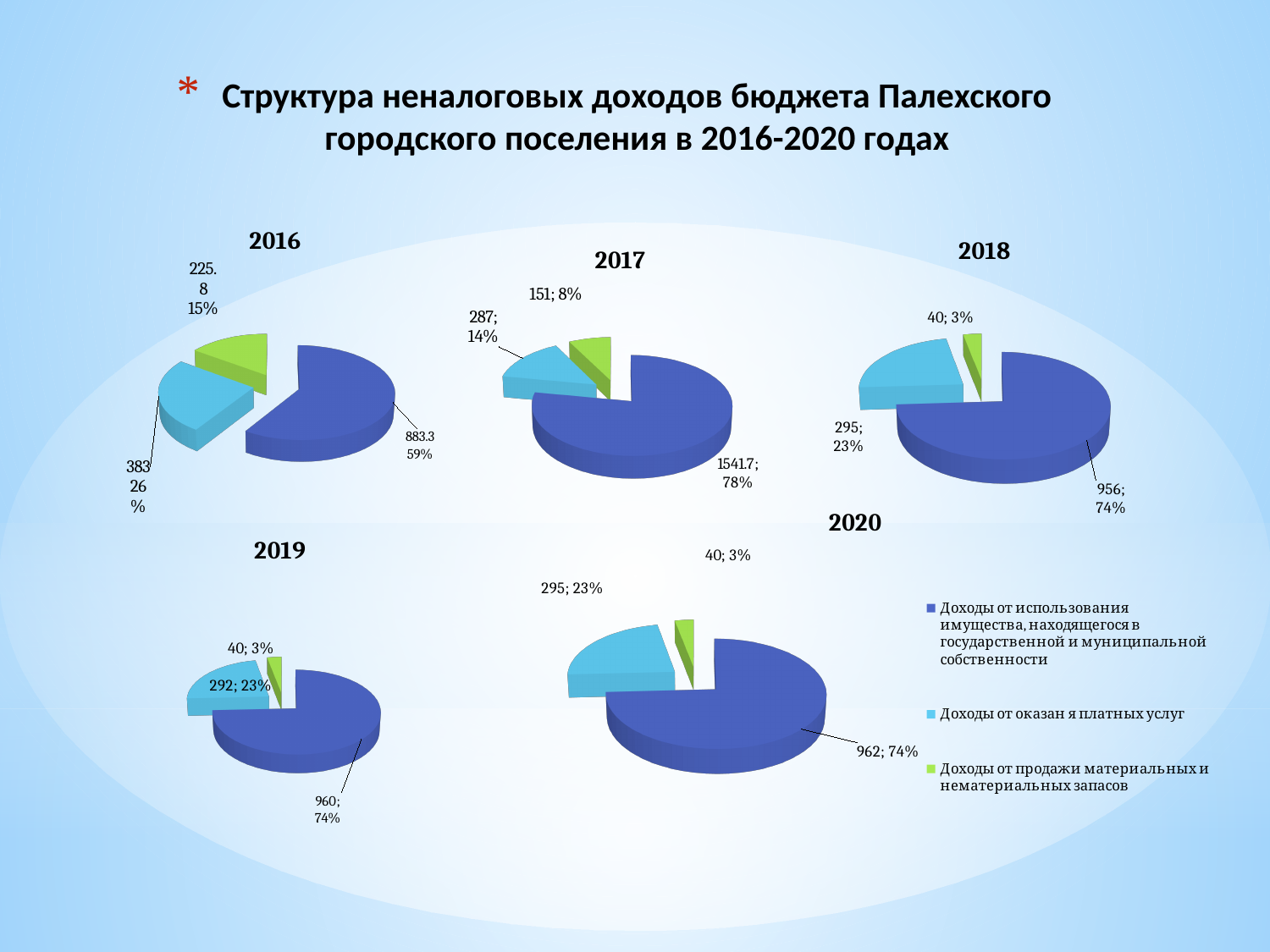
How many pie charts are shown on the slide? 5 In the 2017 pie chart, what share does the green slice (Доходы от продажи материальных и нематериальных запасов) have? 8% In the 2016 pie chart, what share does the largest slice (Доходы от использования имущества) have? 59% In the 2020 pie chart, what is the difference between the largest slice value (962) and the light blue slice value (295)? 667 In the 2019 pie chart, what value is shown for the light blue slice (Доходы от оказания платных услуг)? 292 How many series does the legend list? 3 In the 2017 pie chart, what value is shown for the largest slice? 1541.7 In the 2016 pie chart, what value is shown for the light blue slice (Доходы от оказания платных услуг)? 383 What is the title of the slide? Структура неналоговых доходов бюджета Палехского городского поселения в 2016-2020 годах In the 2018 pie chart, which category has the smallest slice? Доходы от продажи материальных и нематериальных запасов What type of chart is used for each year on the slide? Pie chart Which is larger: the largest slice value in 2017 (1541.7) or the largest slice value in 2018 (956)? 2017 (1541.7)